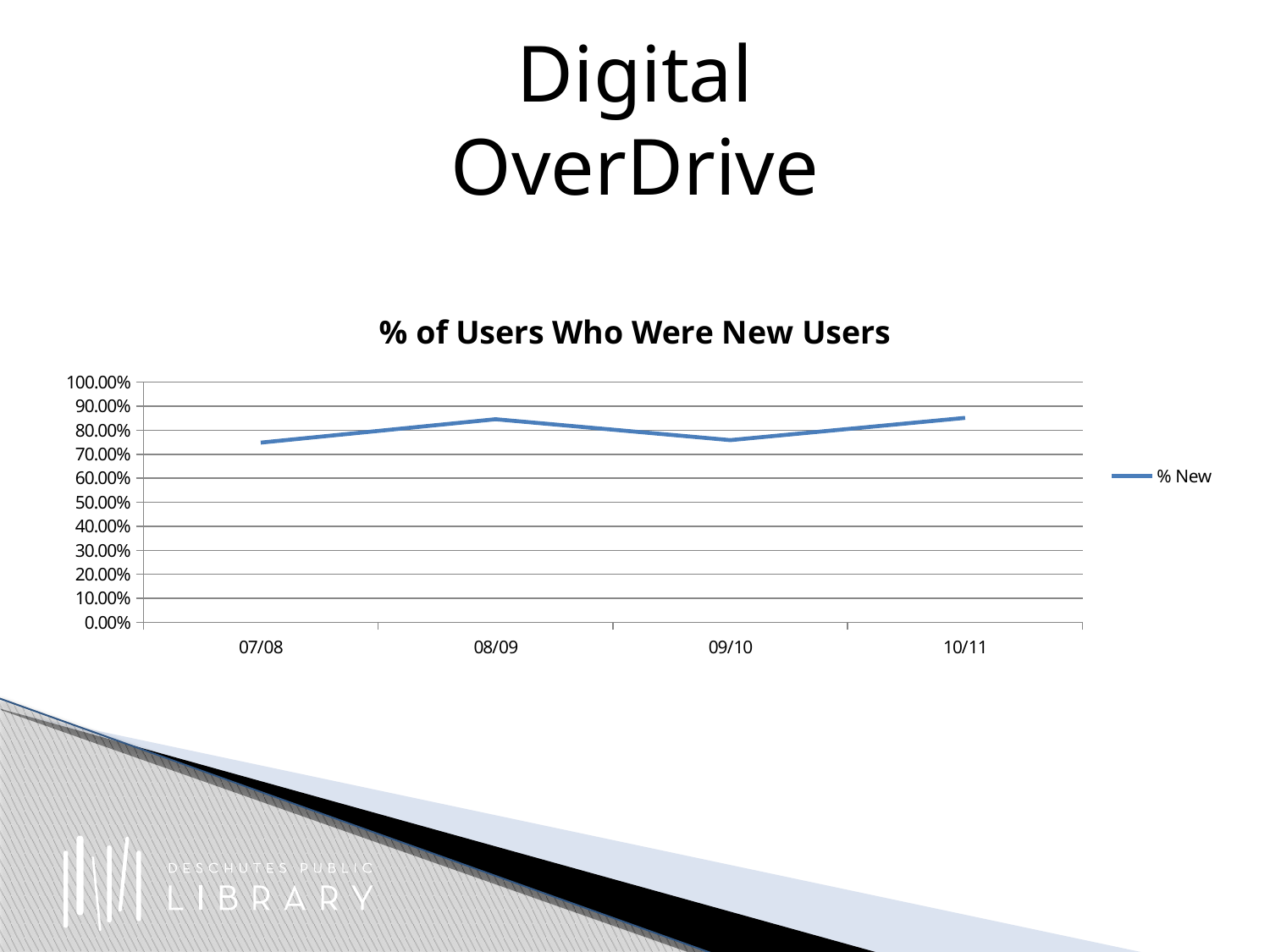
Is the value for 09/10 greater or less than 80.00%? less Which is larger, the value for 09/10 or the value for 10/11? 10/11 Which is larger, the value for 07/08 or the value for 08/09? 08/09 Does the value rise or fall from 08/09 to 09/10? fall How many points are plotted along the x axis? 4 What kind of chart is shown on the slide? line chart Is the value for 08/09 greater or less than 80.00%? greater Is the value for 10/11 greater or less than 70.00%? greater How many series does the legend list? 1 What is the name of the series shown in the legend? % New What is the title of the chart? % of Users Who Were New Users